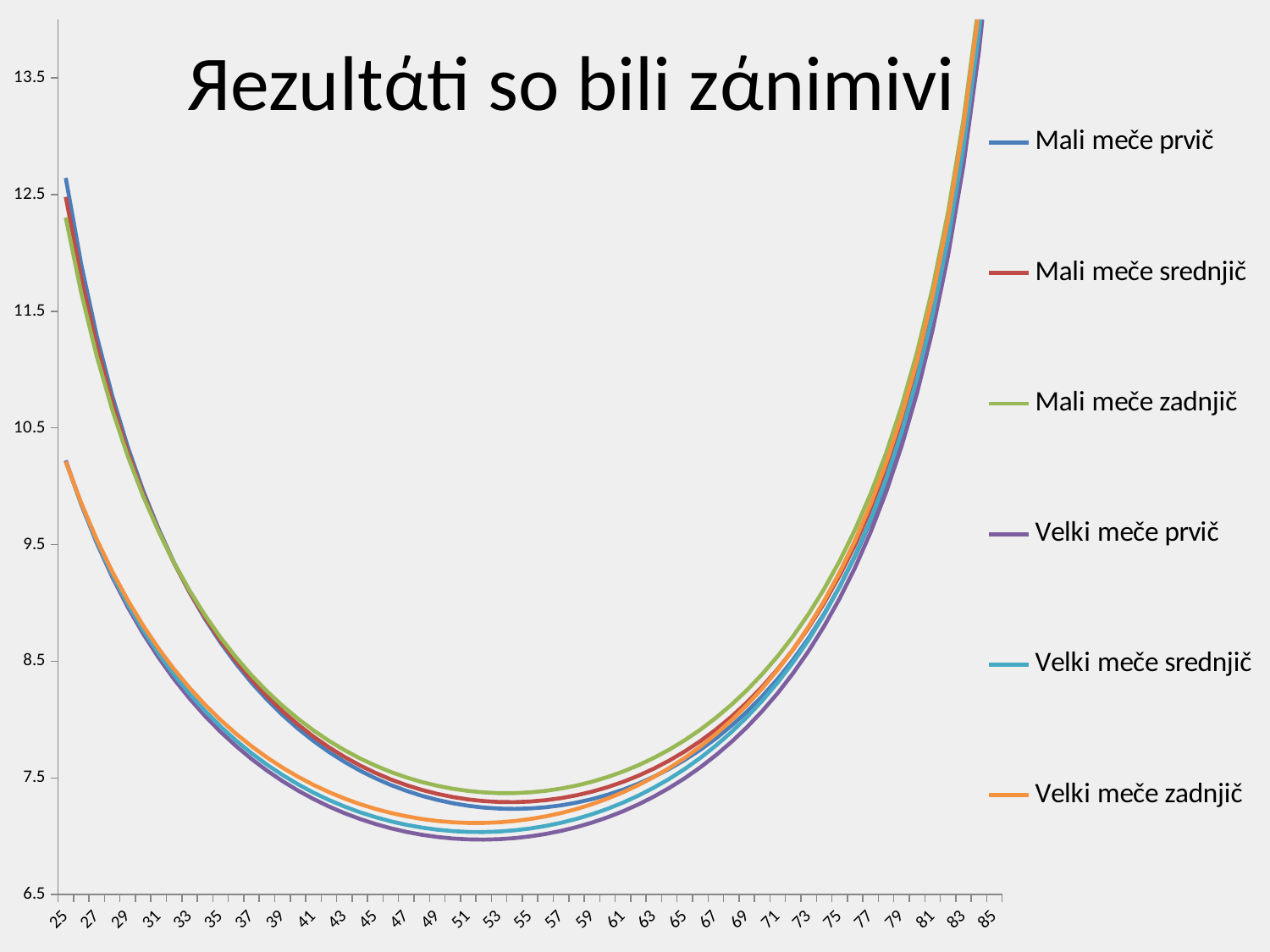
Is the value for Velki meče prvič at 25 greater or less than 10.5? less Which series is drawn in purple according to the legend? Velki meče prvič How many tick labels are shown on the x axis? 31 Is the value for Mali meče prvič at 25 greater or less than 11.5? greater What is the title of the chart? Яezultáti so bili zánimivi How many series does the legend list? 6 At 25, which is larger: the value for Mali meče prvič or the value for Velki meče prvič? Mali meče prvič Is the value for Velki meče zadnjič at 25 greater or less than 9.5? greater What kind of chart is shown on the slide? line chart Do the values of the series fall or rise along the x axis from 25 to 53? fall Do the values of the series fall or rise along the x axis from 55 to 85? rise